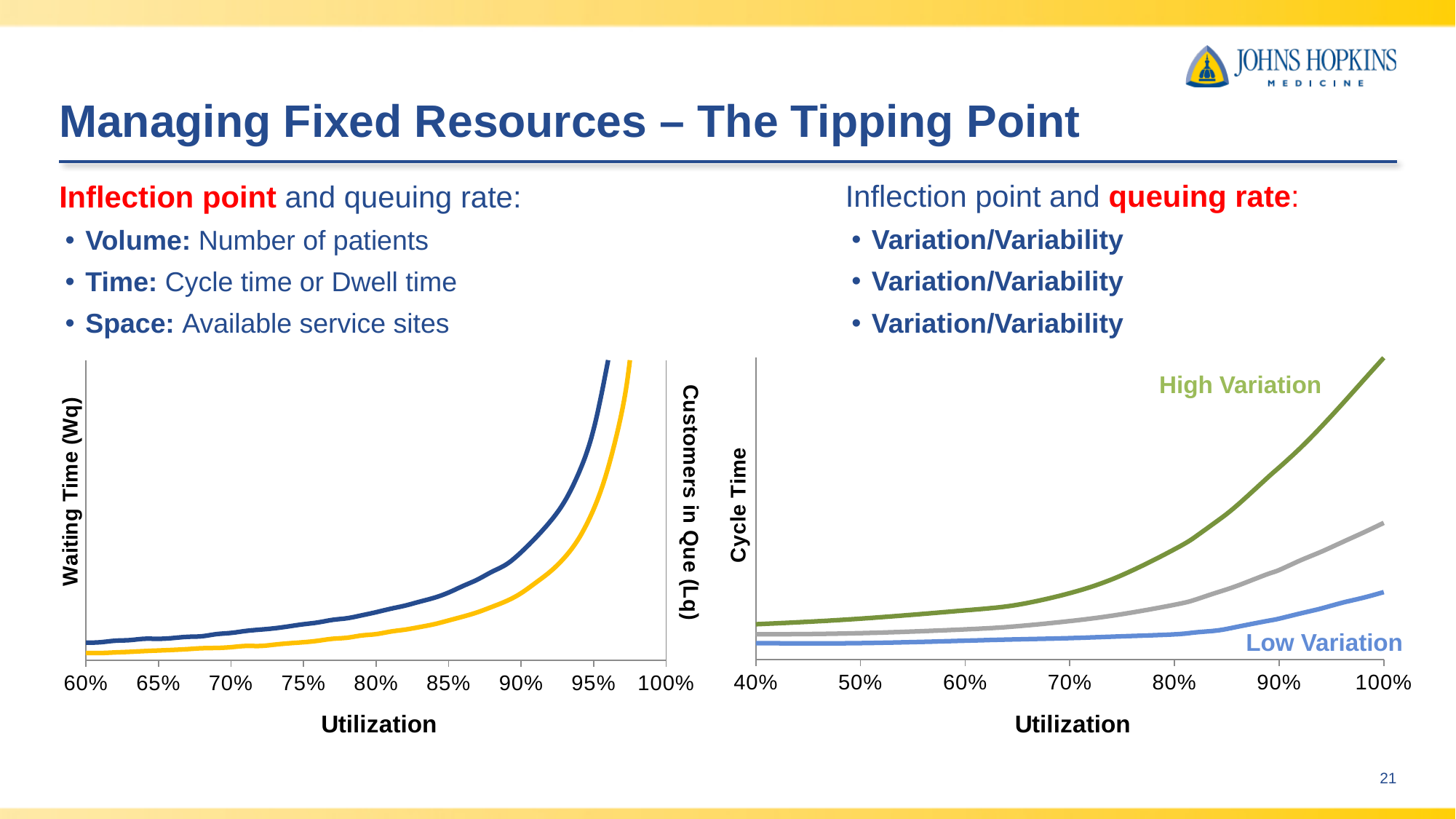
What kind of chart is the left chart with the Waiting Time (Wq) axis? Line chart How many lines are plotted in the left chart? 2 In the right chart, which line is higher at 100% Utilization, High Variation or Low Variation? High Variation In the right chart, does the High Variation line rise or fall as Utilization increases from 40% to 100%? Rise In the right chart, which labelled line has the lowest Cycle Time at 100% Utilization? Low Variation In the right chart, which labelled line has the highest Cycle Time at 100% Utilization? High Variation How many lines are plotted in the right chart? 3 How many tick labels are shown on the x-axis of the right chart? 7 What is the y-axis label of the right chart? Cycle Time What is the x-axis label of the left chart? Utilization What kind of chart is the right chart with the Cycle Time axis? Line chart In the left chart, do the lines rise or fall as Utilization increases from 60% to 100%? Rise